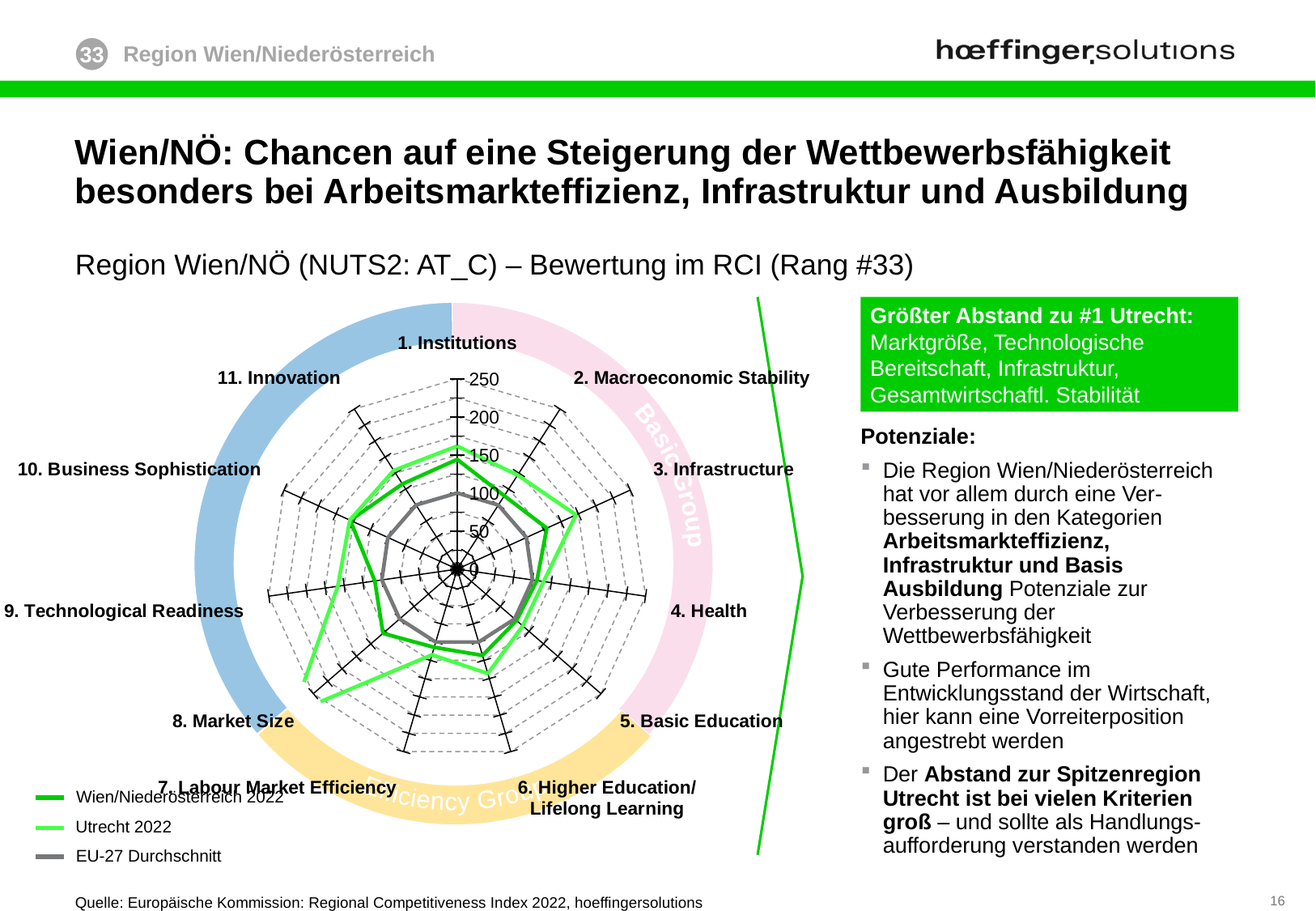
How many categories (axes) does the radar chart have? 11 How many series does the legend of the radar chart list? 3 What is the highest value shown on the radial axis of the radar chart? 250 At 9. Technological Readiness, which is larger: Wien/Niederösterreich 2022 or EU-27 Durchschnitt? Wien/Niederösterreich 2022 Is the value for Utrecht 2022 at 3. Infrastructure greater or less than 100? greater At 3. Infrastructure, which is larger: Utrecht 2022 or EU-27 Durchschnitt? Utrecht 2022 Is the value for Wien/Niederösterreich 2022 at 10. Business Sophistication greater or less than 100? greater Is the value for EU-27 Durchschnitt at 1. Institutions greater or less than 150? less For which category does Wien/Niederösterreich 2022 reach its highest value? 10. Business Sophistication What kind of chart is shown on the slide? Radar chart Which series are listed in the legend of the radar chart? Wien/Niederösterreich 2022, Utrecht 2022, EU-27 Durchschnitt